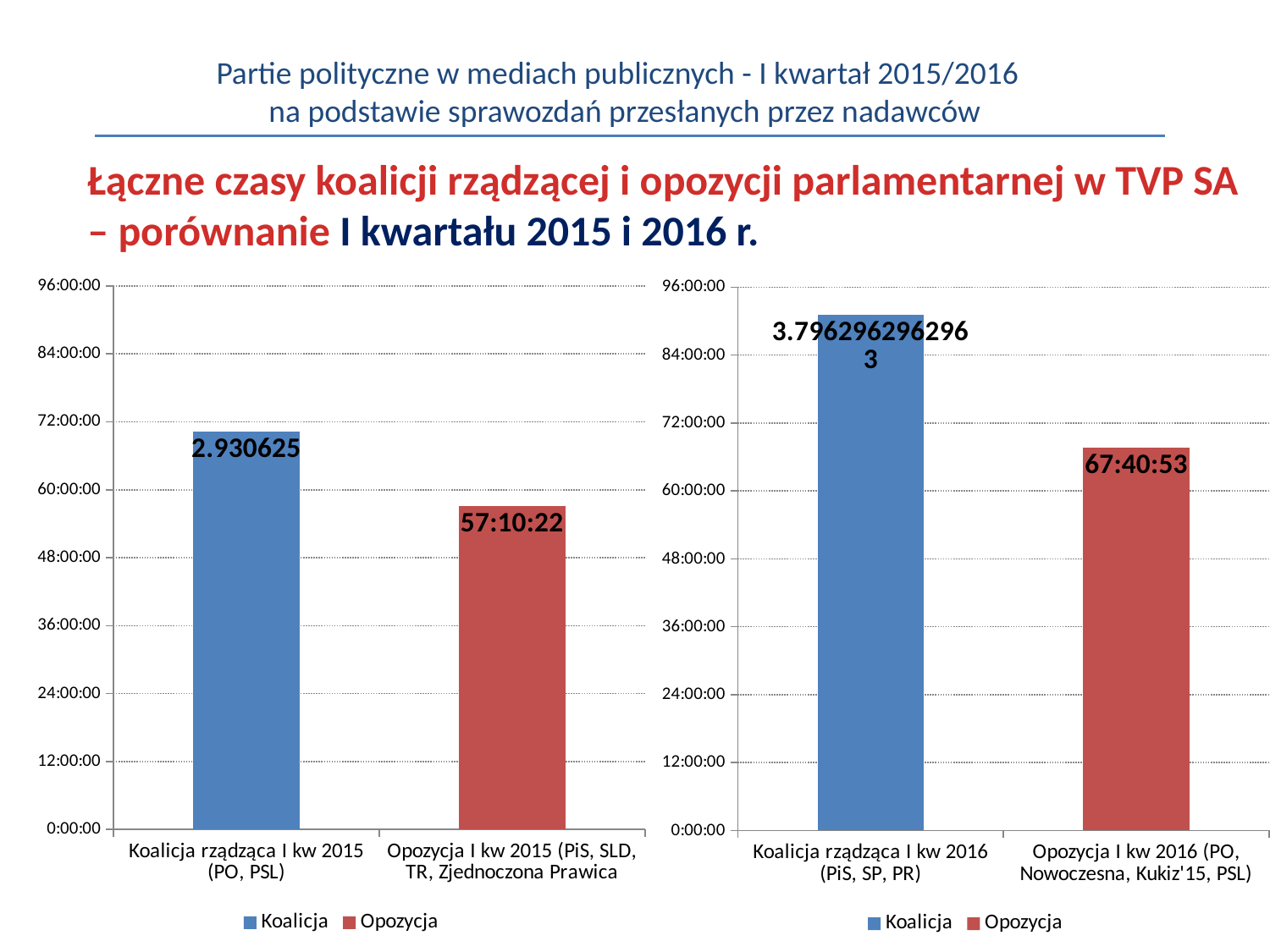
What are the two legend entries shown under each chart? Koalicja and Opozycja Which is larger: the Opozycja value in the left chart (I kw 2015) or the Opozycja value in the right chart (I kw 2016)? Opozycja I kw 2016 (67:40:53) How many bars are plotted in the right chart (I kw 2016)? 2 In the right chart (I kw 2016), which category has the lower bar? Opozycja I kw 2016 (PO, Nowoczesna, Kukiz'15, PSL) What type of chart is used on this slide? Bar chart In the right chart (I kw 2016), is the value for Koalicja rządząca I kw 2016 (PiS, SP, PR) greater or less than 84:00:00? greater In the left chart (I kw 2015), what data label is printed on the Koalicja rządząca I kw 2015 (PO, PSL) bar? 2.930625 In the left chart (I kw 2015), what value is shown for Opozycja I kw 2015 (PiS, SLD, TR, Zjednoczona Prawica)? 57:10:22 In the left chart (I kw 2015), which category has the higher bar? Koalicja rządząca I kw 2015 (PO, PSL) In the left chart (I kw 2015), is the value for Koalicja rządząca I kw 2015 (PO, PSL) greater or less than 60:00:00? greater How many series does the legend of the left chart (I kw 2015) list? 2 In the right chart (I kw 2016), what value is shown for Opozycja I kw 2016 (PO, Nowoczesna, Kukiz'15, PSL)? 67:40:53